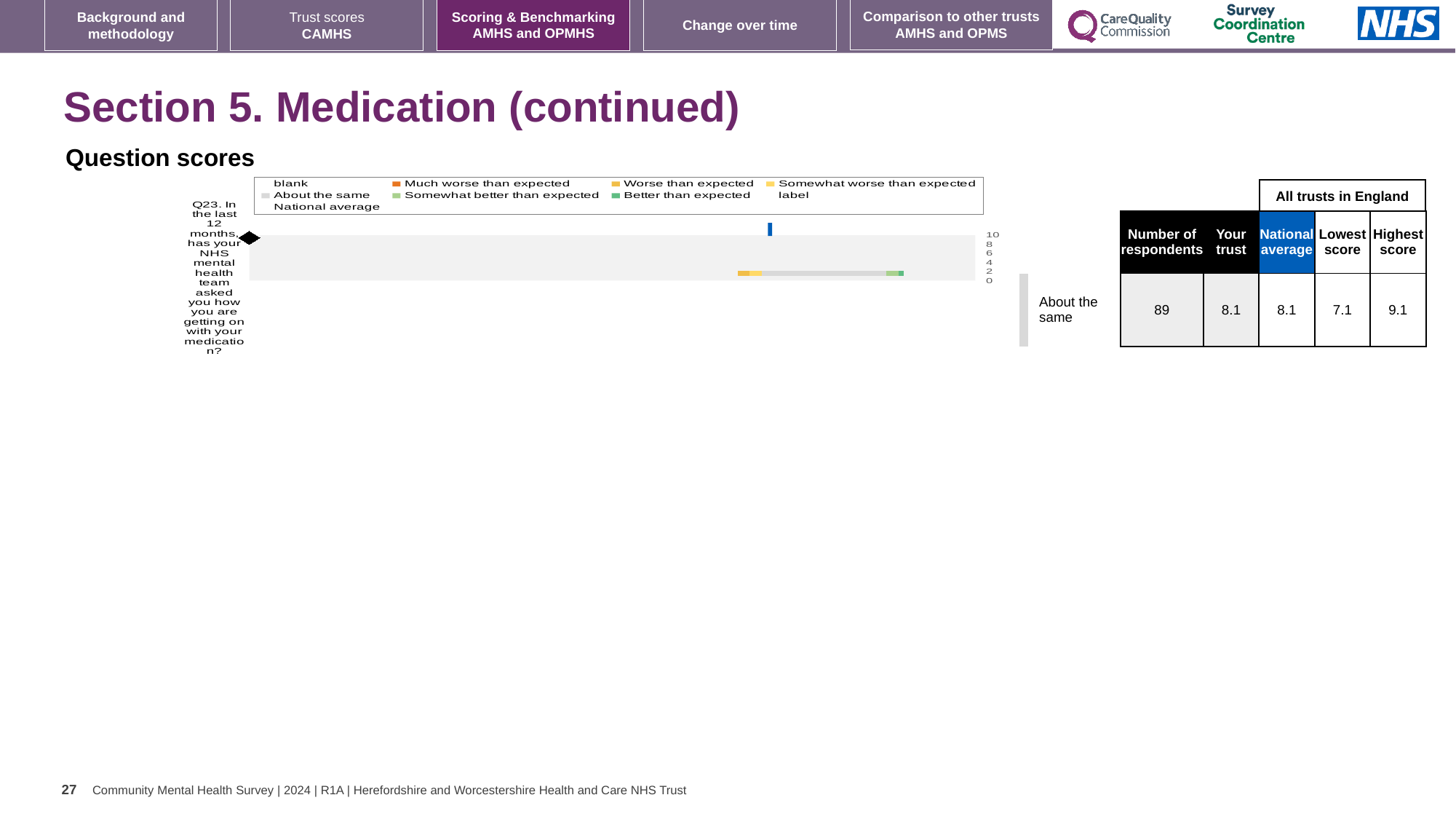
According to the table beside the chart, what is the highest score among all trusts in England for Q23? 9.1 According to the table beside the chart, what is the 'Your trust' score for Q23? 8.1 Is the National average marker for Q23 greater or less than 4 on the chart axis? greater According to the table beside the chart, what is the lowest score among all trusts in England for Q23? 7.1 Which benchmark category is Q23 assigned to, according to the label next to the chart? About the same What is the highest value shown on the chart's axis? 10 Which question is plotted in the chart? Q23. In the last 12 months, has your NHS mental health team asked you how you are getting on with your medication? According to the table beside the chart, what is the National average score for Q23? 8.1 Is the National average marker for Q23 greater or less than 6 on the chart axis? greater According to the table beside the chart, how many respondents answered Q23? 89 What kind of chart is shown under 'Question scores'? bar chart How many questions (categories) are plotted in the chart? 1